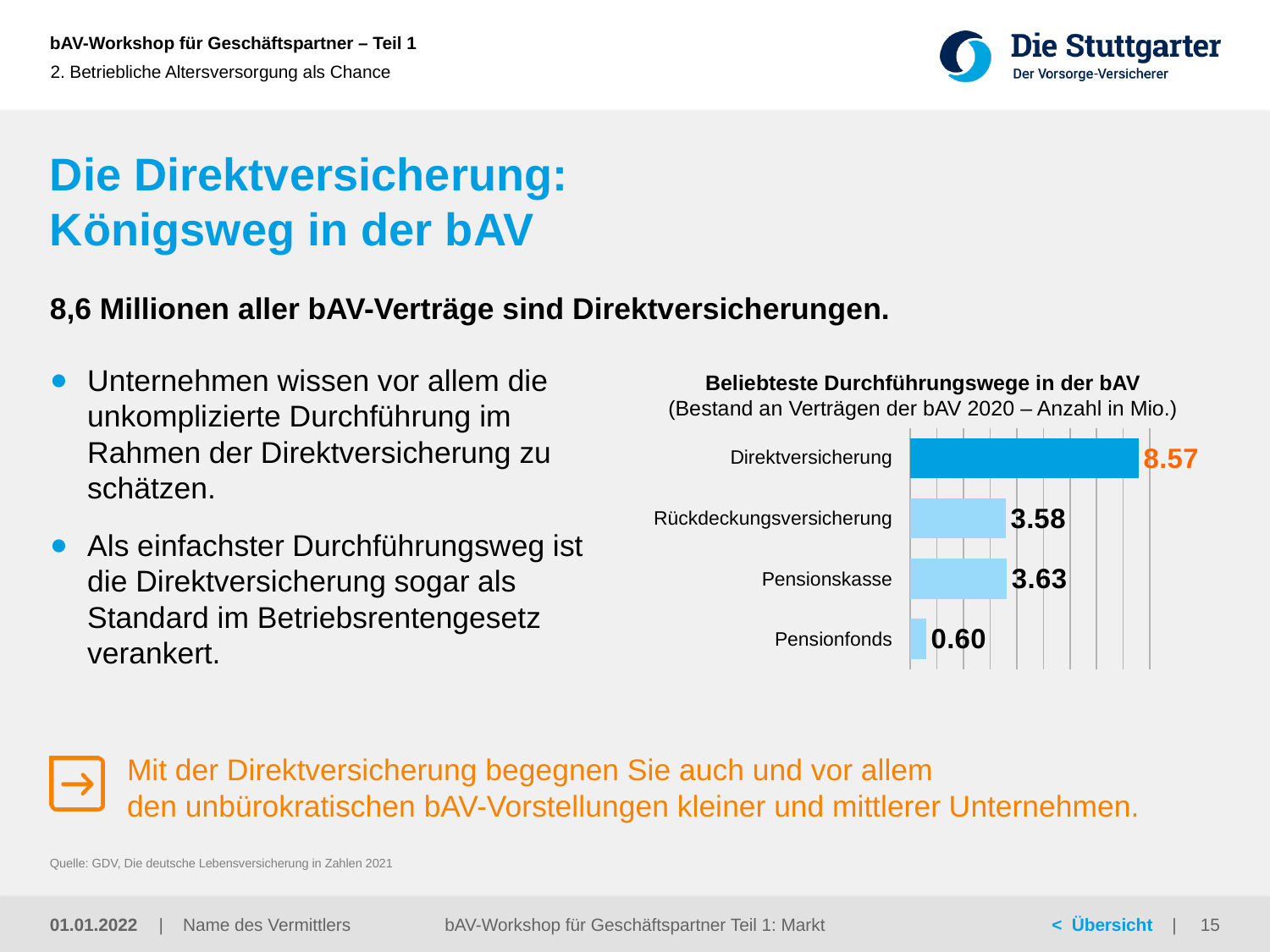
What is the value for Pensionskasse? 3.63 Which category has the lowest value? Pensionfonds What is the title of the chart? Beliebteste Durchführungswege in der bAV Which is larger, the value for Pensionskasse or the value for Rückdeckungsversicherung? Pensionskasse What kind of chart is shown on the slide? Bar chart Which category has the highest value? Direktversicherung What is the value for Pensionfonds? 0.60 How many categories are shown in the chart? 4 What is the difference between the values for Pensionskasse and Pensionfonds? 3.03 What is the value for Direktversicherung? 8.57 What is the value for Rückdeckungsversicherung? 3.58 What is the difference between the values for Direktversicherung and Rückdeckungsversicherung? 4.99